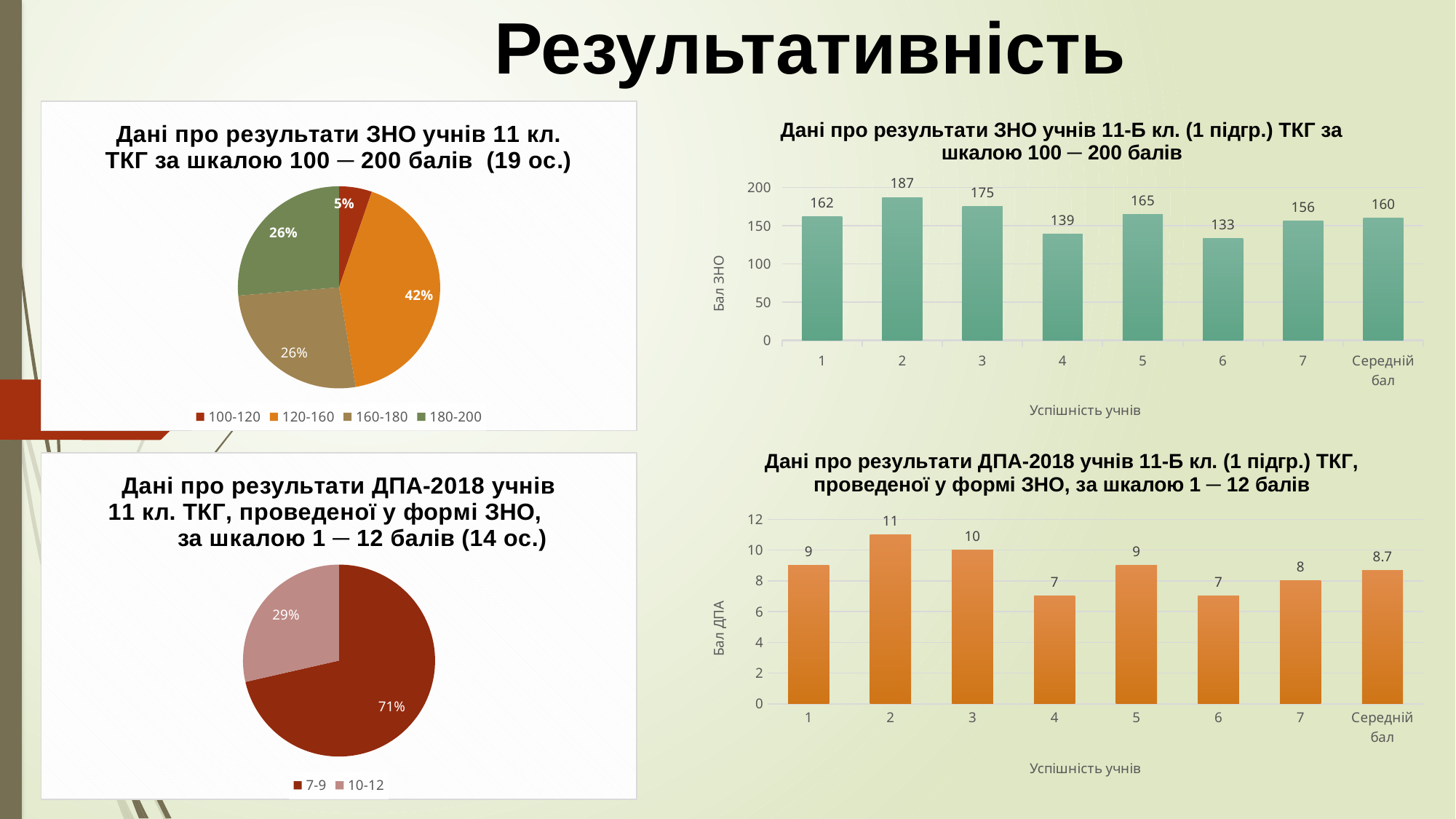
In the bottom-right bar chart (ДПА-2018 results for 11-Б class), is the score of student 3 larger than the score of student 7? Yes In the bottom-left pie chart (ДПА-2018 results, 14 students), what share does the 7-9 range have? 71% How many bars are plotted in the bottom-right bar chart (ДПА-2018 results for 11-Б class)? 8 In the top-right bar chart (ЗНО results for 11-Б class), what is the value shown for Середній бал? 160 In the bottom-right bar chart (ДПА-2018 results for 11-Б class), which student has the highest score? 2 In the top-left pie chart (ЗНО results, 19 students), what share does the 120-160 range have? 42% In the top-right bar chart (ЗНО results for 11-Б class), what is the difference between the scores of student 2 and student 6? 54 In the top-left pie chart (ЗНО results, 19 students), which score range has the smallest share? 100-120 In the bottom-right bar chart (ДПА-2018 results for 11-Б class), what is the value for Середній бал? 8.7 In the top-right bar chart (ЗНО results for 11-Б class), which student has the lowest score? 6 How many categories does the legend of the top-left pie chart (ЗНО results, 19 students) list? 4 In the top-right bar chart (ЗНО results for 11-Б class), what is the value for student 2? 187